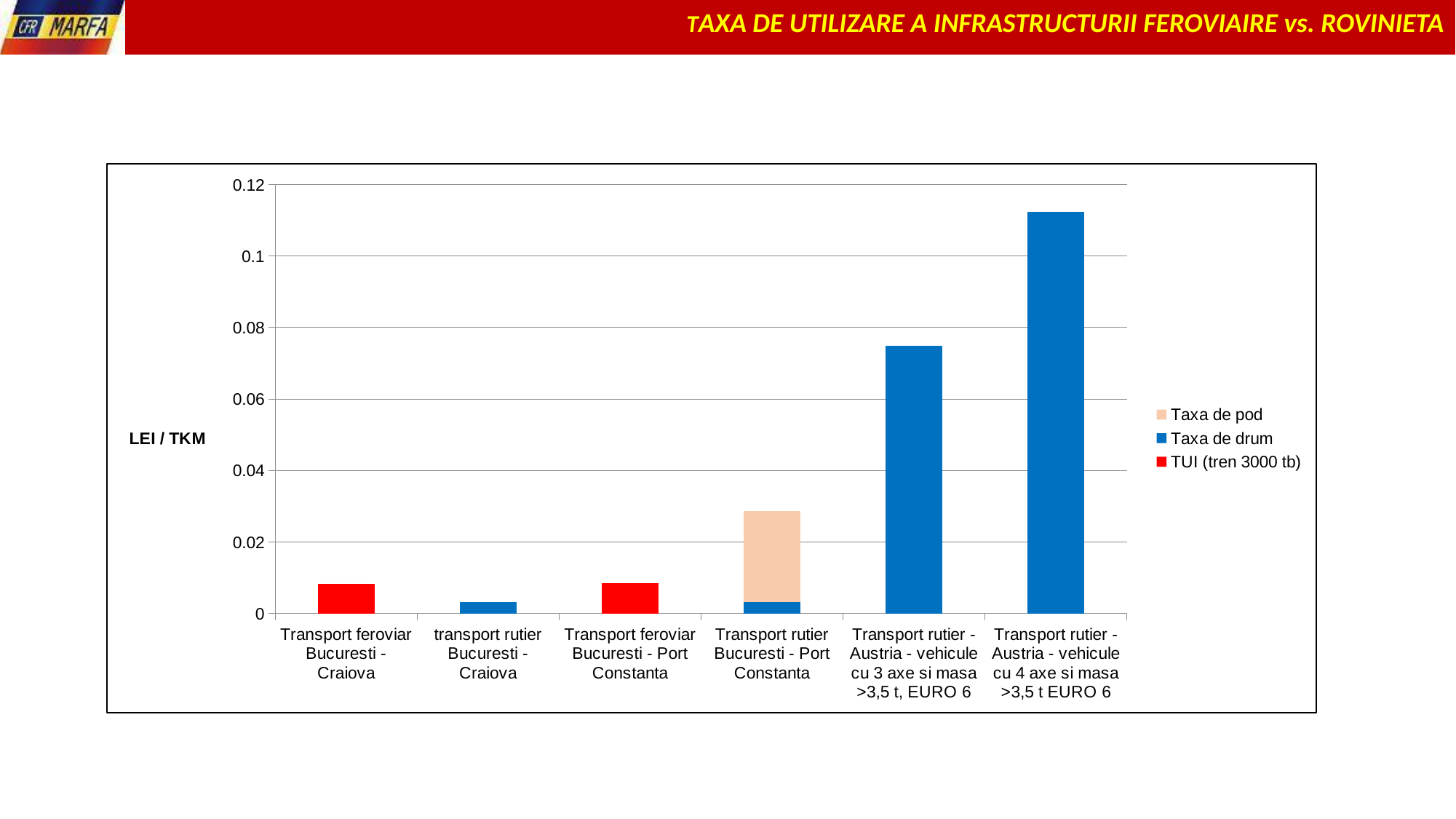
What is the label on the vertical axis of the chart? LEI / TKM Which series in the legend is shown in red? TUI (tren 3000 tb) What kind of chart is shown on the slide? bar chart How many categories are shown on the x axis of the chart? 6 Which category has the lowest bar in the chart? transport rutier Bucuresti - Craiova How many series does the chart's legend list? 3 Is the value for Transport rutier - Austria - vehicule cu 4 axe si masa >3,5 t EURO 6 greater or less than 0.1? greater Is the total height of the stacked bar for Transport rutier Bucuresti - Port Constanta greater or less than 0.04? less Is the value for Transport rutier - Austria - vehicule cu 3 axe si masa >3,5 t, EURO 6 greater or less than 0.08? less Which category has the highest bar in the chart? Transport rutier - Austria - vehicule cu 4 axe si masa >3,5 t EURO 6 Which is larger: the bar for Transport feroviar Bucuresti - Craiova or the bar for transport rutier Bucuresti - Craiova? Transport feroviar Bucuresti - Craiova